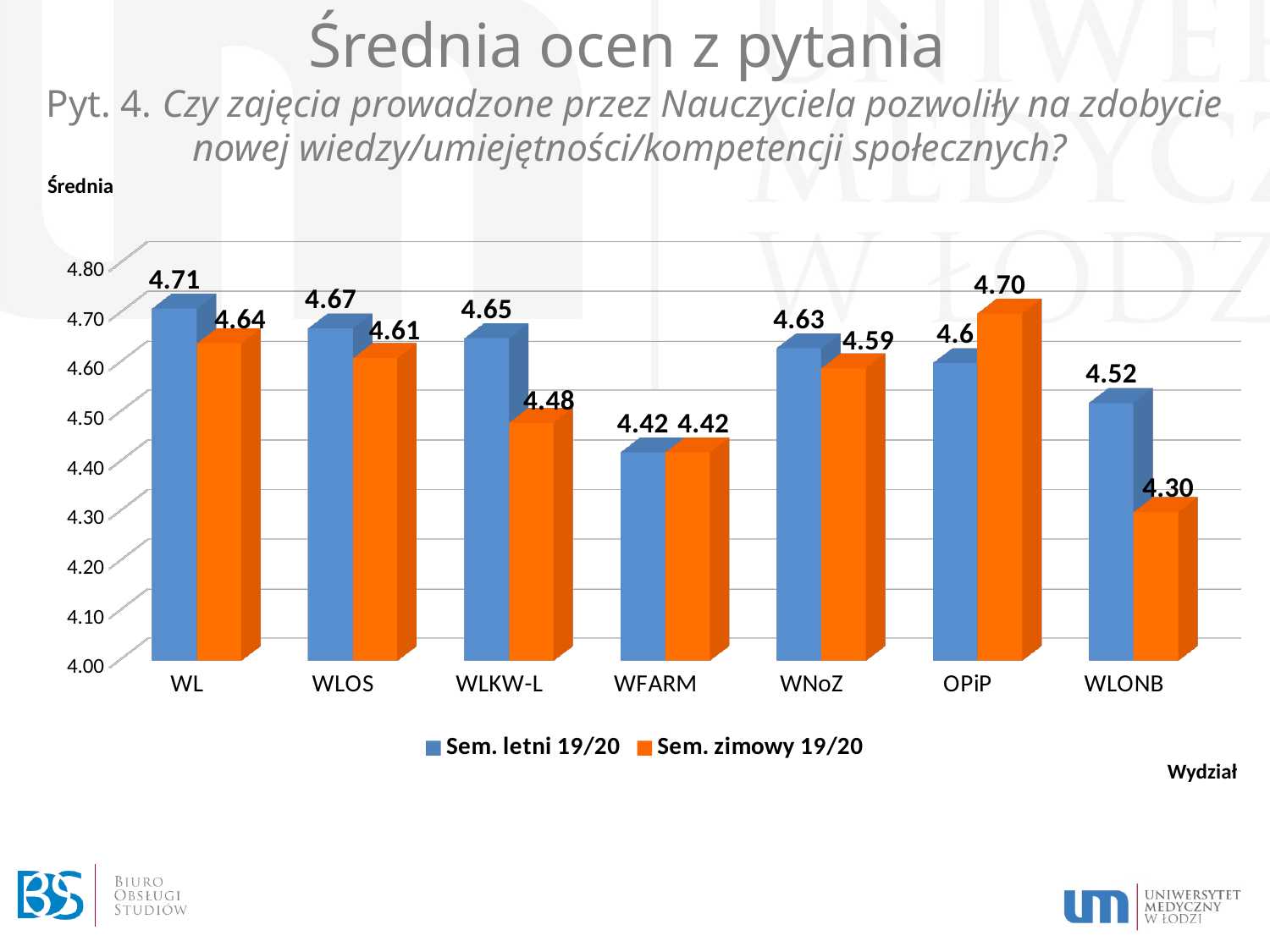
Which category has the same value in both series? WFARM What kind of chart is shown on the slide? bar chart What is the difference between the Sem. letni 19/20 and Sem. zimowy 19/20 values for WLONB? 0.22 Which is larger for OPiP: the Sem. letni 19/20 value or the Sem. zimowy 19/20 value? Sem. zimowy 19/20 What is the value for WL in the Sem. letni 19/20 series? 4.71 What is the value for WLONB in the Sem. zimowy 19/20 series? 4.30 Which category has the lowest value in the Sem. zimowy 19/20 series? WLONB How many series does the legend list? 2 What is the label of the vertical axis? Średnia Which category has the highest value in the Sem. letni 19/20 series? WL How many categories are shown on the x axis? 7 What is the value for OPiP in the Sem. letni 19/20 series? 4.6